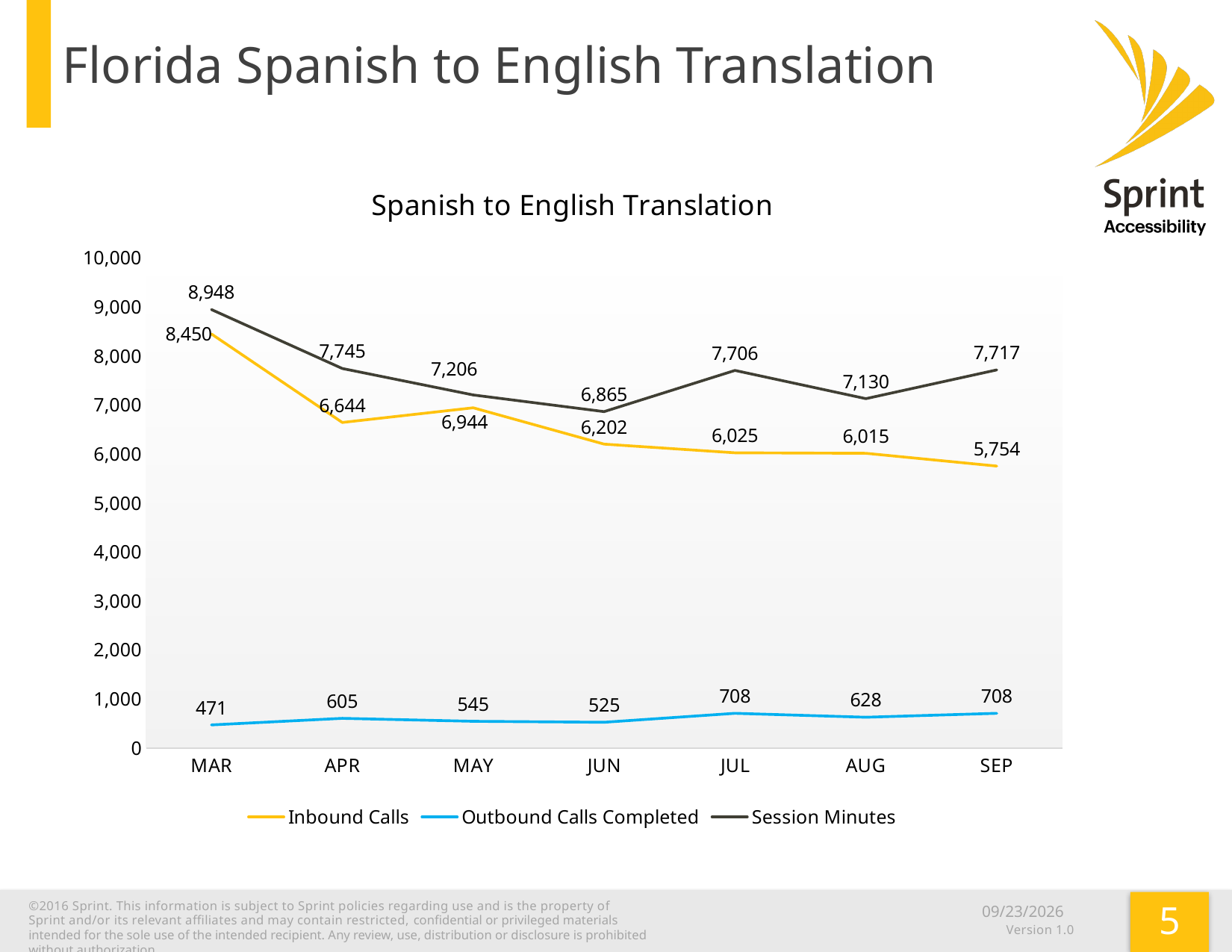
What is the value of Session Minutes in JUL? 7,706 What kind of chart is shown on the slide? Line chart Which month has more Inbound Calls, APR or MAY? MAY In which month are Session Minutes highest? MAR What is the difference between Session Minutes and Inbound Calls in MAR? 498 In which month are Outbound Calls Completed lowest? MAR How many series does the legend list? 3 What is the value of Inbound Calls in MAR? 8,450 In which month are Inbound Calls lowest? SEP What is the value of Outbound Calls Completed in APR? 605 How many months are shown on the x axis? 7 By how much did Session Minutes increase from AUG to SEP? 587